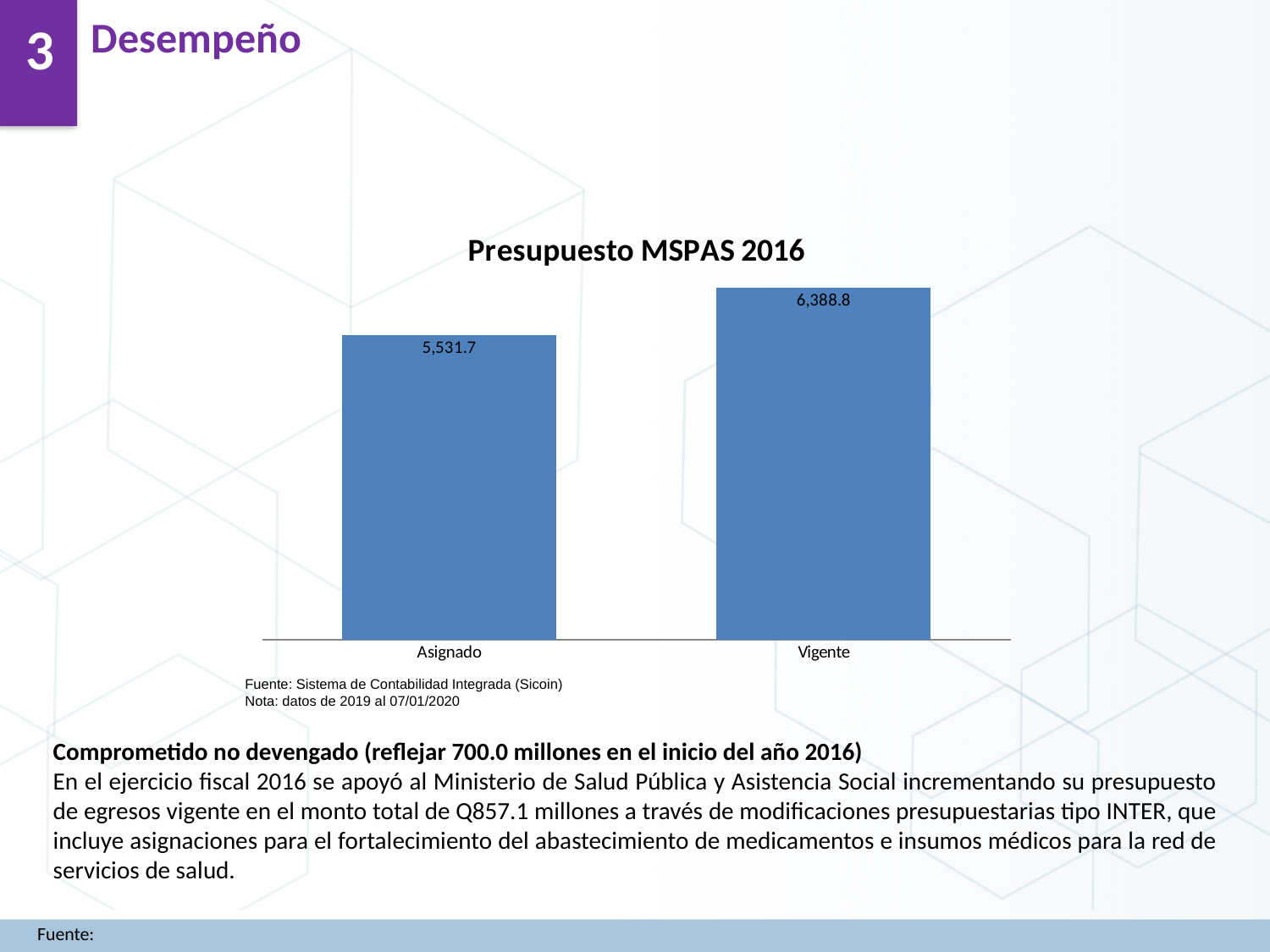
What kind of chart is the Presupuesto MSPAS 2016 chart? Bar chart Which category has the highest value in the Presupuesto MSPAS 2016 chart? Vigente What source is cited below the Presupuesto MSPAS 2016 chart? Sistema de Contabilidad Integrada (Sicoin) What is the value for Asignado in the Presupuesto MSPAS 2016 chart? 5,531.7 Which is larger in the Presupuesto MSPAS 2016 chart, Asignado or Vigente? Vigente What is the difference between the Vigente and Asignado values in the Presupuesto MSPAS 2016 chart? 857.1 How many categories are shown in the Presupuesto MSPAS 2016 chart? 2 What is the title of the chart on the slide? Presupuesto MSPAS 2016 Do the values rise or fall from Asignado to Vigente in the Presupuesto MSPAS 2016 chart? Rise What is the value for Vigente in the Presupuesto MSPAS 2016 chart? 6,388.8 Which category has the lowest value in the Presupuesto MSPAS 2016 chart? Asignado